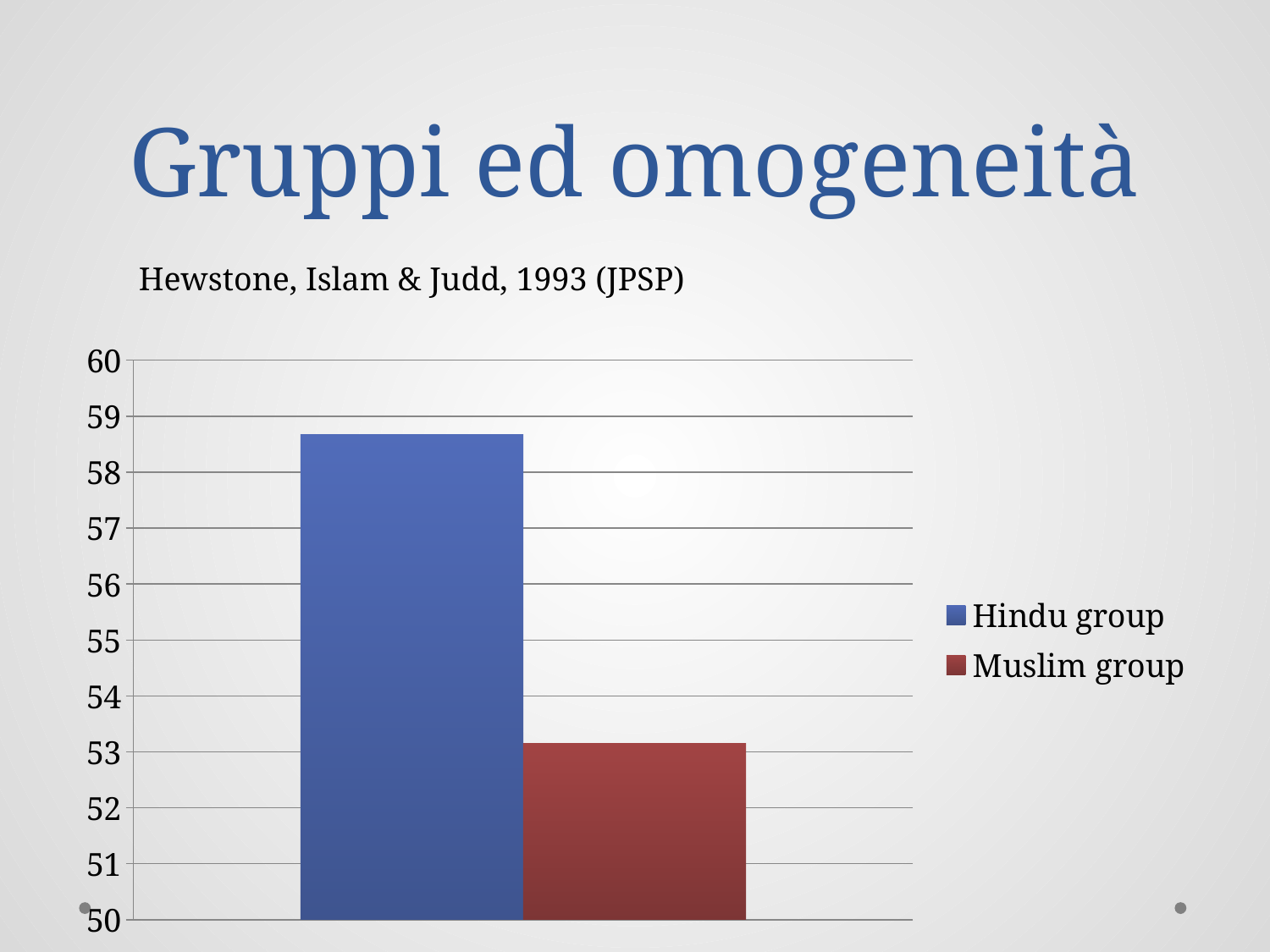
Which group has the highest bar in the chart? Hindu group Which group has the lowest bar in the chart? Muslim group Is the value for the Hindu group greater or less than 59? less Is the value for the Muslim group greater or less than 52? greater Is the value for the Hindu group greater or less than 58? greater Which is larger, the value for the Hindu group or the value for the Muslim group? Hindu group How many series does the chart legend list? 2 How many bars are plotted in the chart? 2 What is the lowest value shown on the vertical axis of the chart? 50 What colour is the bar for the Muslim group? red What kind of chart is shown on the slide? bar chart